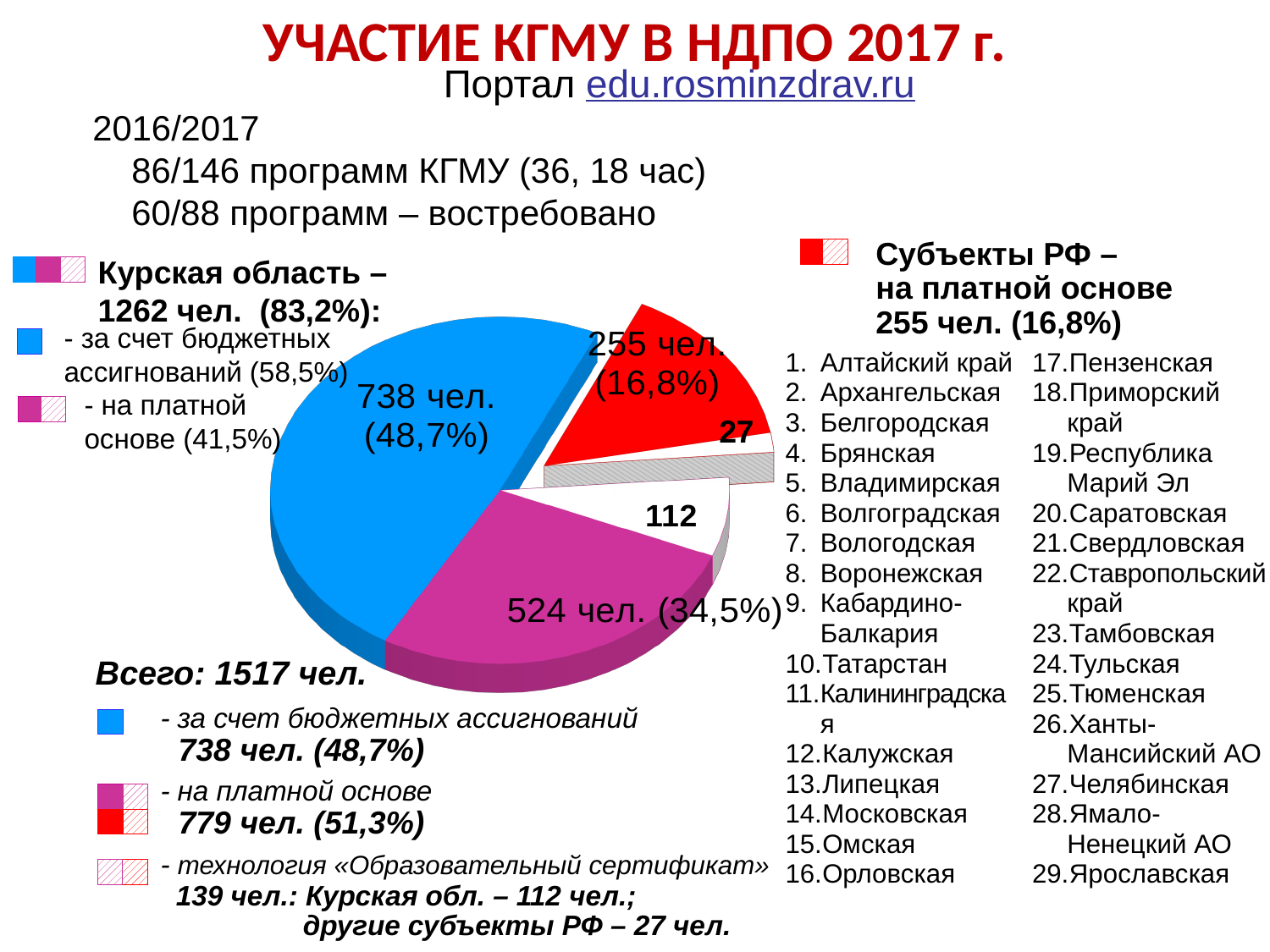
How many people are in the magenta slice (Курская область, на платной основе) of the pie chart? 524 чел. What kind of chart is shown on the slide? pie chart Which slice of the pie chart is the largest? за счет бюджетных ассигнований (738 чел.) What percentage share does the red slice (Субъекты РФ – на платной основе) have in the pie chart? 16,8% Which of the three main slices of the pie chart is the smallest? Субъекты РФ – на платной основе (255 чел.) What is the total number of people represented by the pie chart (Всего)? 1517 чел. What percentage share does the blue slice (за счет бюджетных ассигнований) have in the pie chart? 48,7% How many people are in the red slice (Субъекты РФ – на платной основе) of the pie chart? 255 чел. How many people are in the blue slice (за счет бюджетных ассигнований) of the pie chart? 738 чел. Which is larger: the magenta slice (Курская область, на платной основе) or the red slice (Субъекты РФ)? the magenta slice (524 чел.) What does the hatched pattern on the pie chart represent according to the legend? технология «Образовательный сертификат» What is the difference in people between the blue slice (738 чел.) and the magenta slice (524 чел.)? 214 чел.